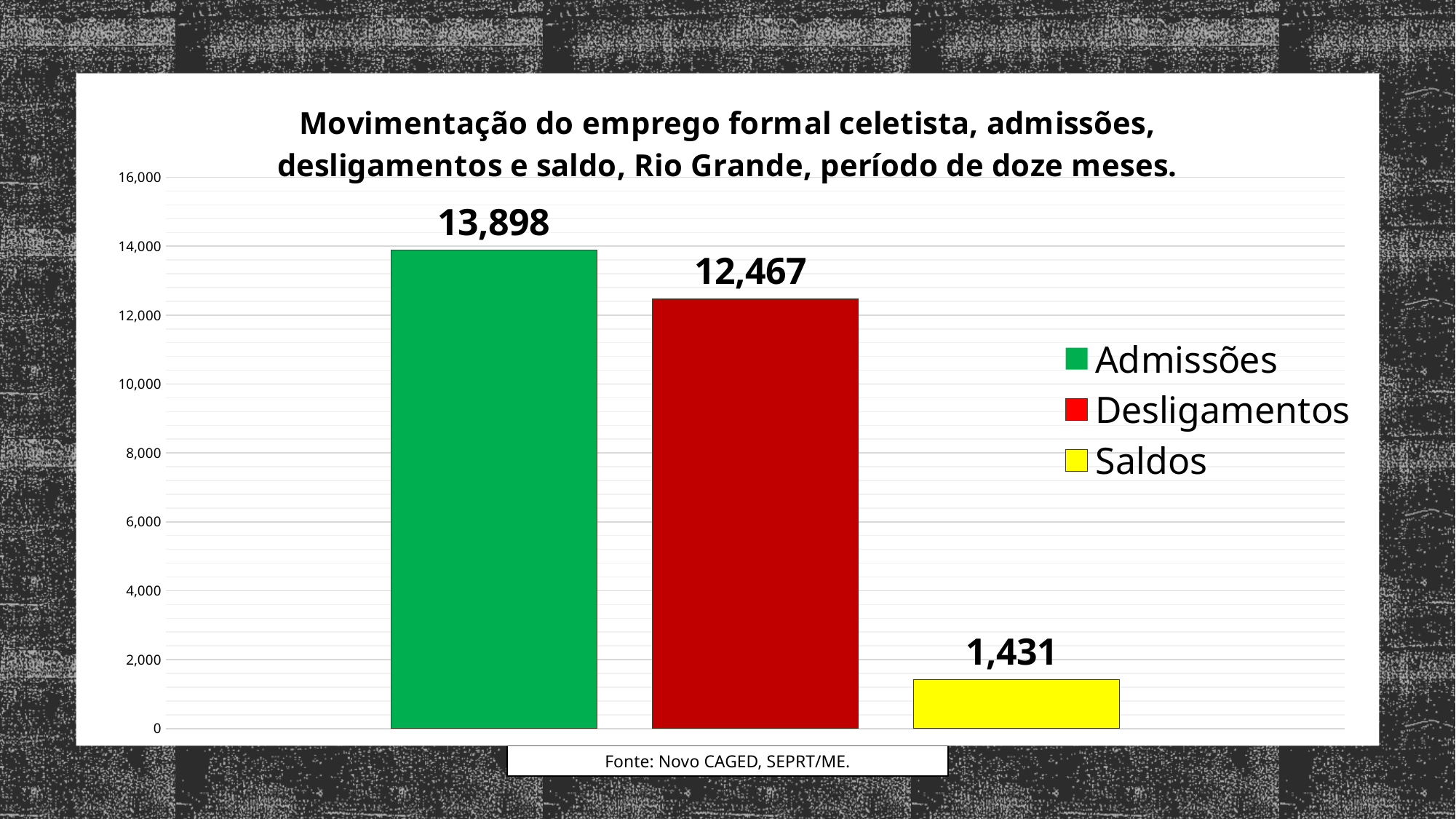
How many series does the legend list? 3 Which series has the lowest value? Saldos Which series has the highest value? Admissões Is the value for Desligamentos greater or less than 12,000? greater What is the value for Desligamentos? 12,467 What is the difference between Admissões and Desligamentos? 1,431 Which is larger, Desligamentos or Saldos? Desligamentos What colour is the bar for Saldos? yellow What kind of chart is shown on the slide? bar chart What is the value for Saldos? 1,431 What is the value for Admissões? 13,898 How many bars are plotted in the chart? 3